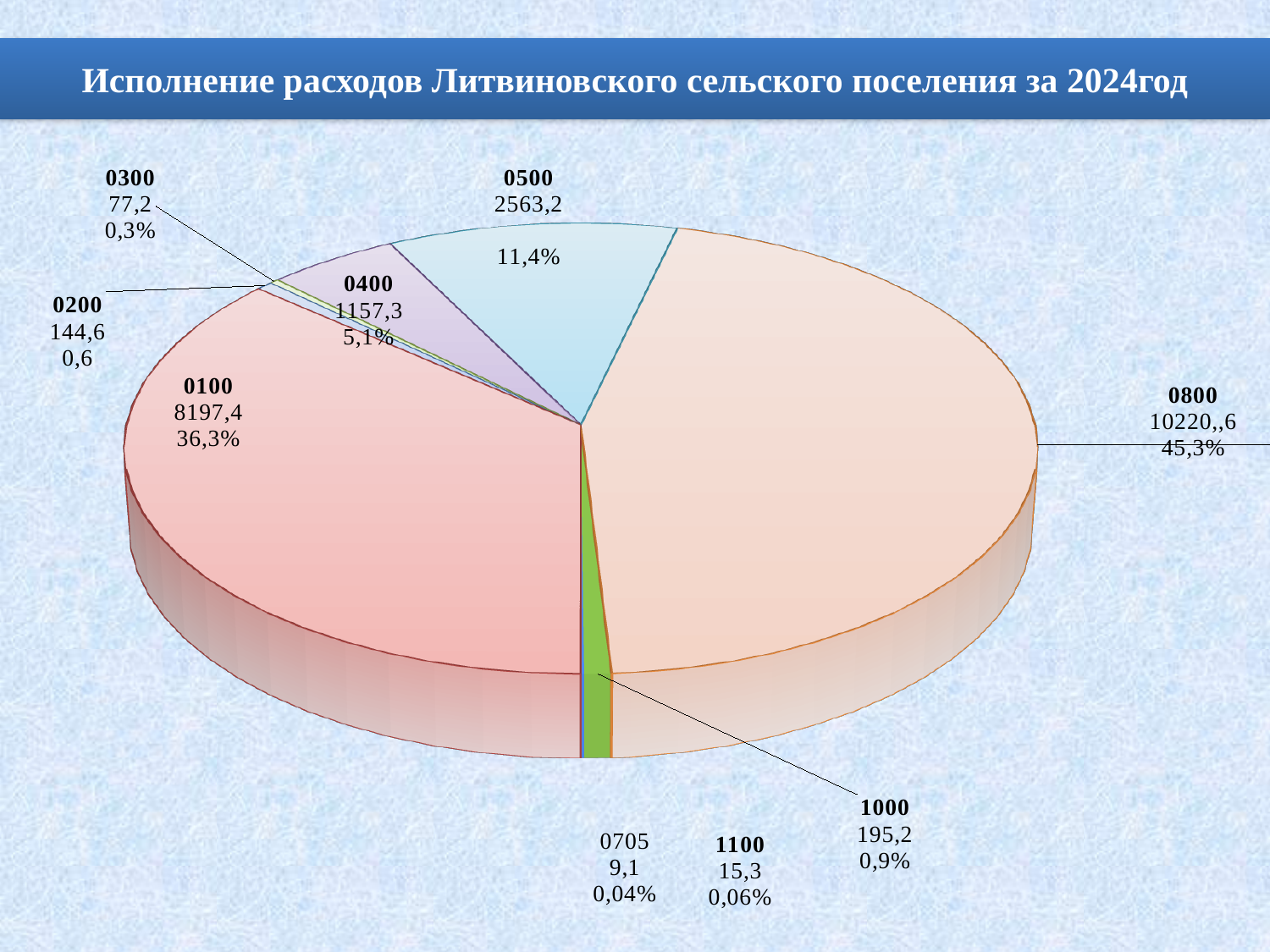
Which is larger, the value for 0100 or the value for 0500? 0100 What is the value shown for category 0500? 2563,2 What share of the pie does category 0100 represent? 36,3% What is the title of the chart? Исполнение расходов Литвиновского сельского поселения за 2024год Which category has the largest slice of the pie? 0800 What is the value shown for category 0100? 8197,4 What kind of chart is shown on the slide? pie chart What is the value shown for category 0400? 1157,3 How many categories (slices) does the pie chart have? 9 What is the difference between the values for 0100 and 0500? 5634,2 Which category has the smallest value in the pie chart? 0705 What share of the pie does category 0800 represent? 45,3%